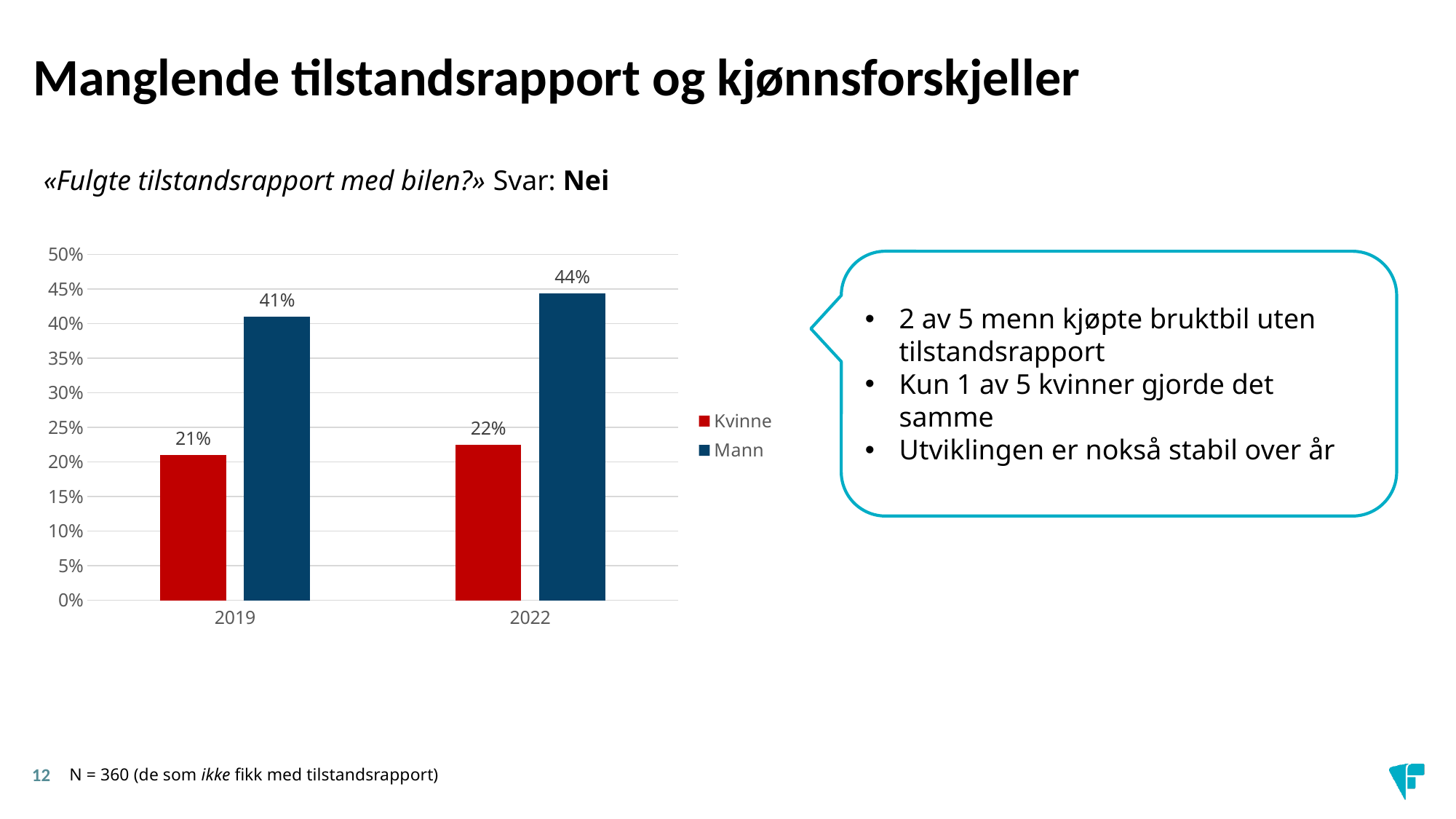
What kind of chart is shown on the slide? Bar chart What is the value for Mann in 2019? 41% Which is larger in 2019, Kvinne or Mann? Mann Which series has the highest value in the chart? Mann What is the difference between Mann and Kvinne in 2019? 20% Does the value for Mann rise or fall from 2019 to 2022? Rise What is the value for Kvinne in 2022? 22% What is the value for Mann in 2022? 44% Which bar has the lowest value in the chart? Kvinne in 2019 What is the value for Kvinne in 2019? 21% What is the difference between Mann and Kvinne in 2022? 22% How many series does the legend list? 2